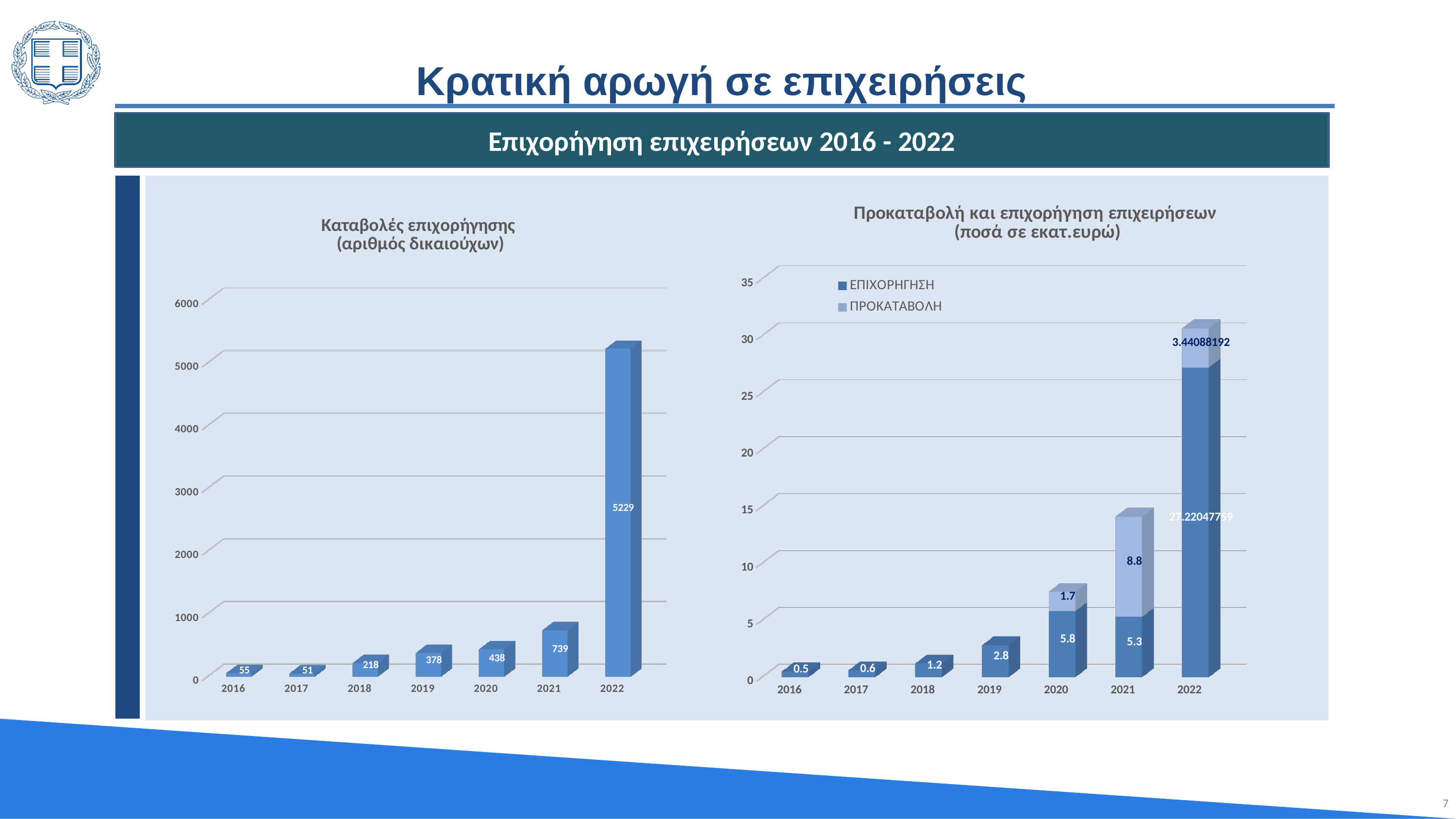
In the left chart (Καταβολές επιχορήγησης), what is the difference between the values for 2021 and 2020? 301 In the left chart (Καταβολές επιχορήγησης), how many years are shown on the x axis? 7 In the left chart (Καταβολές επιχορήγησης), what is the value for 2022? 5229 In the left chart (Καταβολές επιχορήγησης), which year has the lowest value? 2017 In the right chart (Προκαταβολή και επιχορήγηση επιχειρήσεων), what is the total of the stacked bar for 2020? 7.5 In the right chart (Προκαταβολή και επιχορήγηση επιχειρήσεων), which is larger: the ΕΠΙΧΟΡΗΓΗΣΗ value for 2020 or for 2021? 2020 In the left chart (Καταβολές επιχορήγησης), what is the value for 2019? 378 In the right chart (Προκαταβολή και επιχορήγηση επιχειρήσεων), what is the ΠΡΟΚΑΤΑΒΟΛΗ value for 2021? 8.8 In the right chart (Προκαταβολή και επιχορήγηση επιχειρήσεων), what is the ΕΠΙΧΟΡΗΓΗΣΗ value for 2020? 5.8 What kind of chart is the left chart (Καταβολές επιχορήγησης)? Bar chart In the right chart (Προκαταβολή και επιχορήγηση επιχειρήσεων), how many series does the legend list? 2 In the right chart (Προκαταβολή και επιχορήγηση επιχειρήσεων), what is the ΕΠΙΧΟΡΗΓΗΣΗ value for 2022? 27.22047759